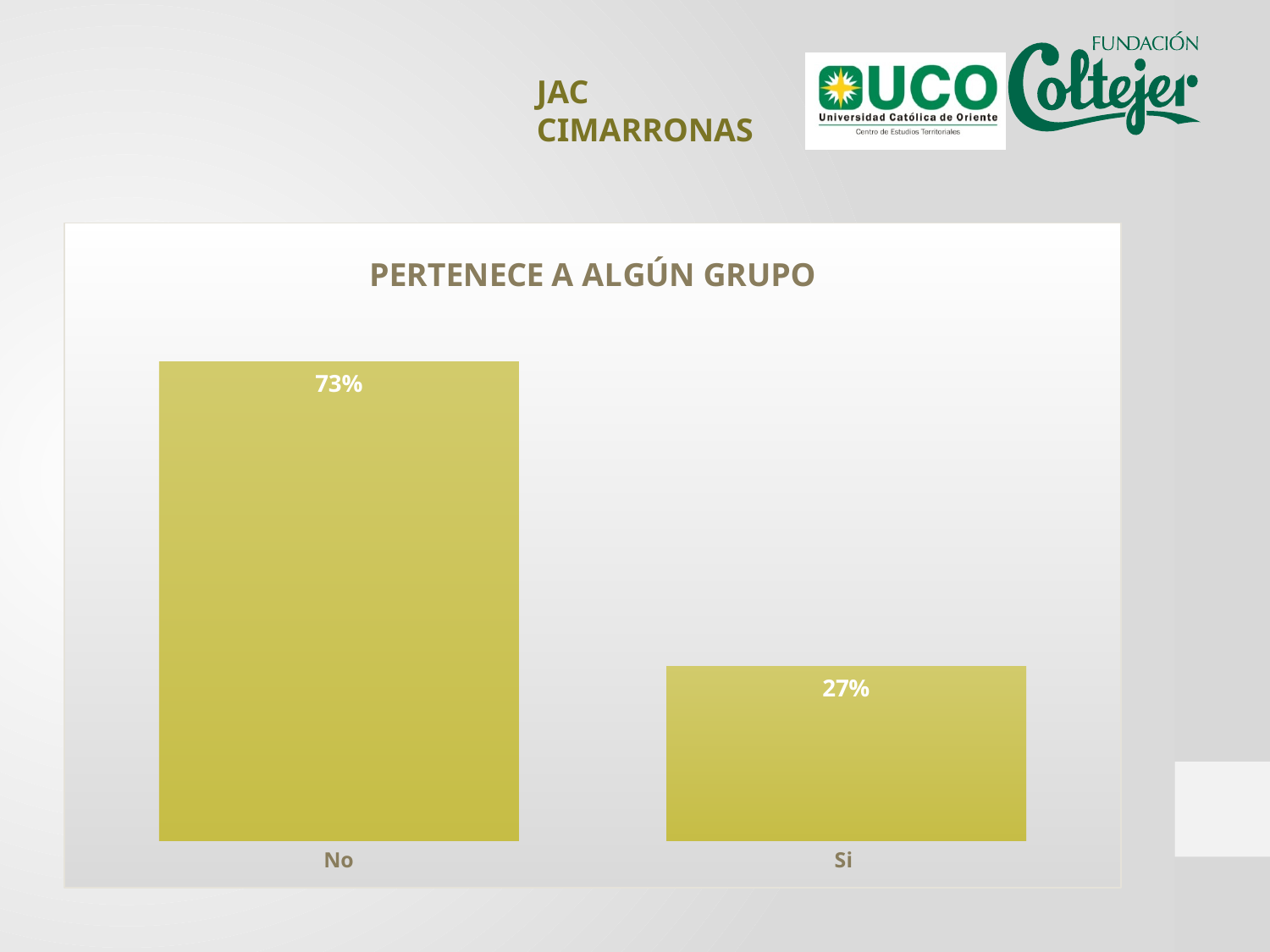
What is the value for "Si" in the chart? 27% What colour are the bars in the chart? Yellow Which category has the highest value? No What is the difference between the values for "No" and "Si"? 46% How many categories are shown in the chart? 2 What is the total of the two values shown in the chart? 100% Which category has the lowest value? Si What kind of chart is shown on the slide? Bar chart What is the value for "No" in the chart? 73% What is the title of the chart? PERTENECE A ALGÚN GRUPO Which is larger, the value for "No" or the value for "Si"? No